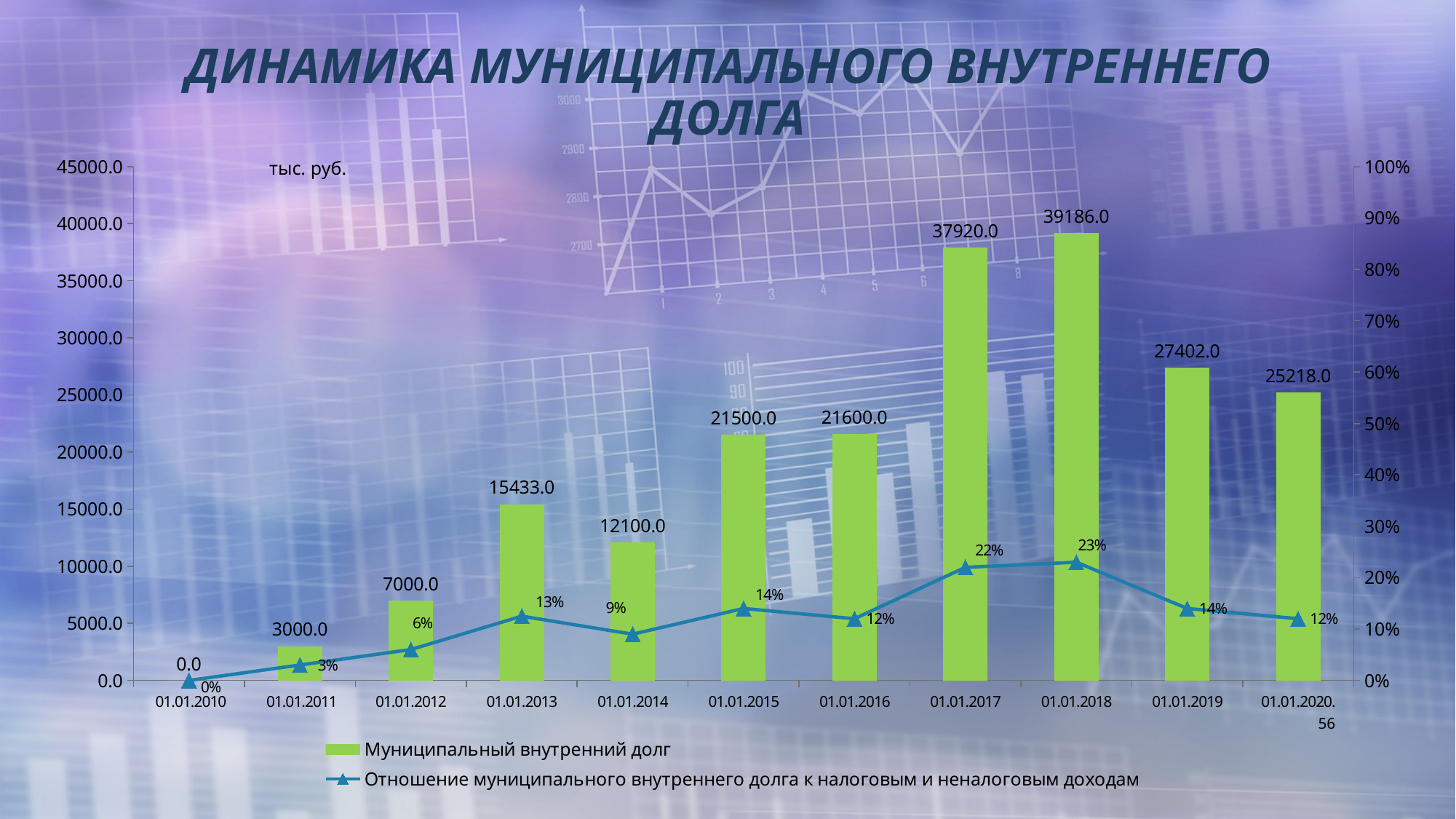
On which date is the municipal internal debt lowest? 01.01.2010 What kind of chart is used for the municipal internal debt series? Bar chart What is the difference between the municipal internal debt on 01.01.2018 and on 01.01.2017? 1266.0 What is the value of the municipal internal debt (Муниципальный внутренний долг) on 01.01.2018? 39186.0 Which is larger: the municipal internal debt on 01.01.2019 or on 01.01.2020? 01.01.2019 What is the value of the municipal internal debt on 01.01.2013? 15433.0 Does the municipal internal debt rise or fall from 01.01.2018 to 01.01.2020? Fall On which date is the municipal internal debt highest? 01.01.2018 What is the ratio of municipal internal debt to tax and non-tax revenues on 01.01.2017? 22% What unit is shown at the top of the left axis? тыс. руб. How many dates are shown on the x axis of the chart? 11 How many series does the legend list? 2